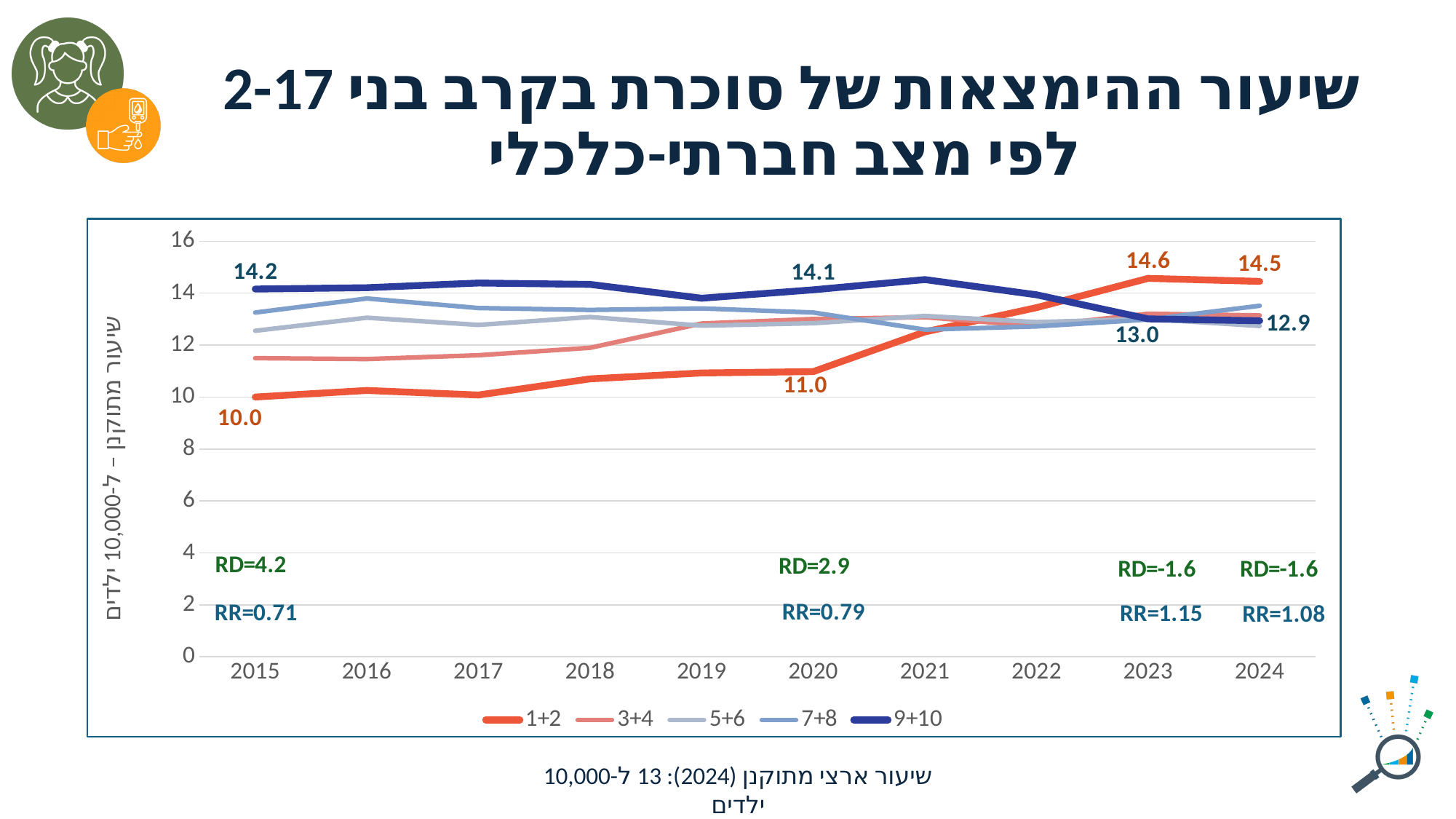
How many years are shown on the x axis? 10 How many series does the legend list? 5 Which is larger in 2024, series 1+2 or series 9+10? 1+2 What is the value for series 1+2 in 2023? 14.6 Does the value for series 1+2 rise or fall from 2015 to 2024? rise Is the value for series 3+4 in 2015 greater or less than 12? less What is the value for series 1+2 in 2020? 11.0 What kind of chart is shown on the slide? line chart What is the value for series 9+10 in 2015? 14.2 What is the difference between series 9+10 and series 1+2 in 2015? 4.2 What is the value for series 9+10 in 2024? 12.9 What is the value for series 1+2 in 2015? 10.0